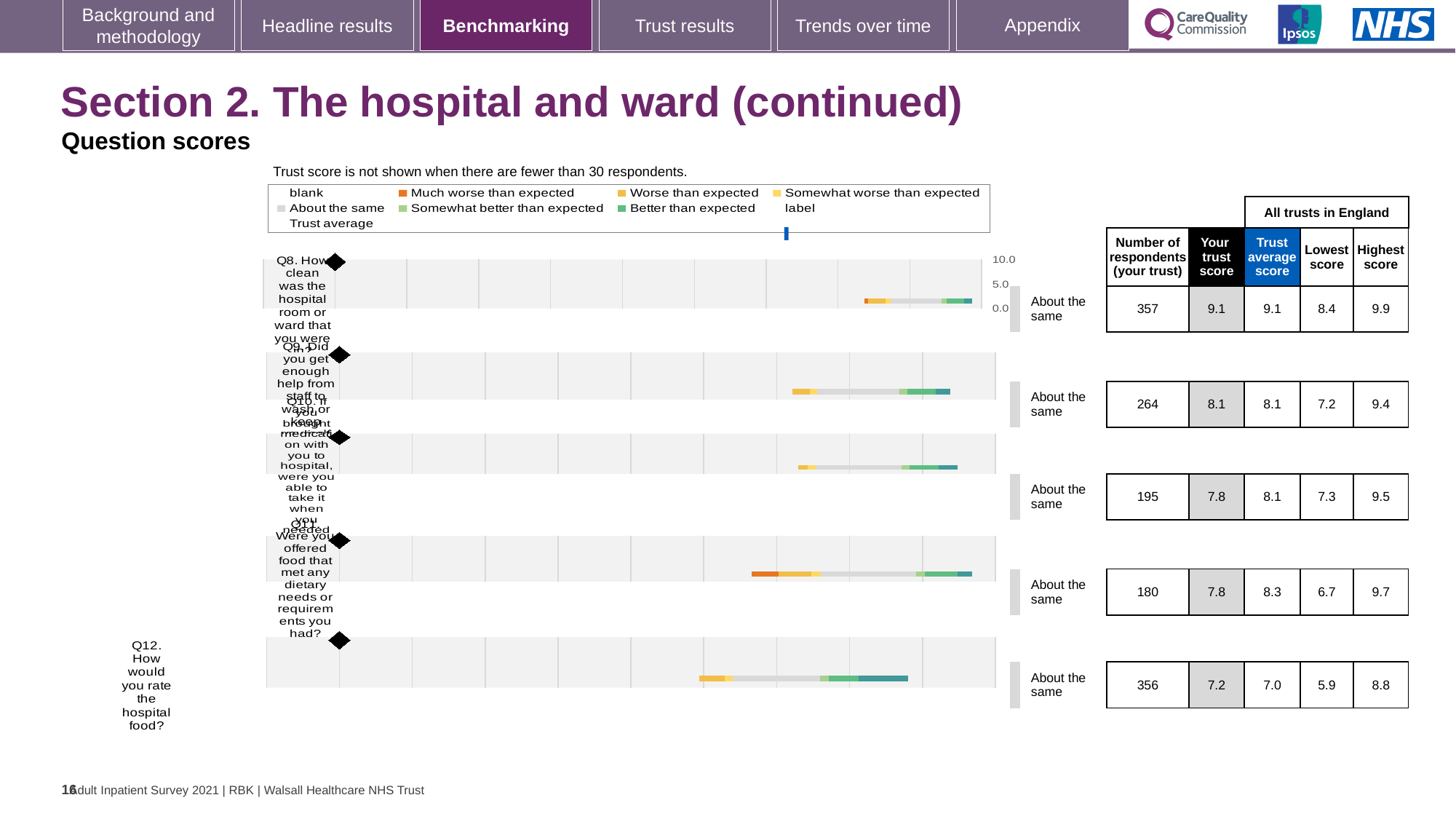
Which question has the highest 'Your trust score'? Q8 How many respondents from your trust answered Q12 (how would you rate the hospital food)? 356 For Q11, which is larger: your trust score or the trust average score? Trust average score Which legend entry is shown in dark orange? Much worse than expected What kind of chart is used to show the question scores on this slide? Bar chart What benchmark category is shown next to Q9 (did you get enough help from staff to wash or keep yourself clean)? About the same How many more respondents answered Q8 than Q11 at your trust? 177 What is the lowest score across all trusts in England for Q10? 7.3 Which question has the lowest 'Your trust score'? Q12 For Q12, what is the difference between the highest score and the lowest score across all trusts in England? 2.9 What is the 'Your trust score' for Q8 (how clean was the hospital room or ward)? 9.1 How many questions (Q8 to Q12) are plotted in the chart? 5